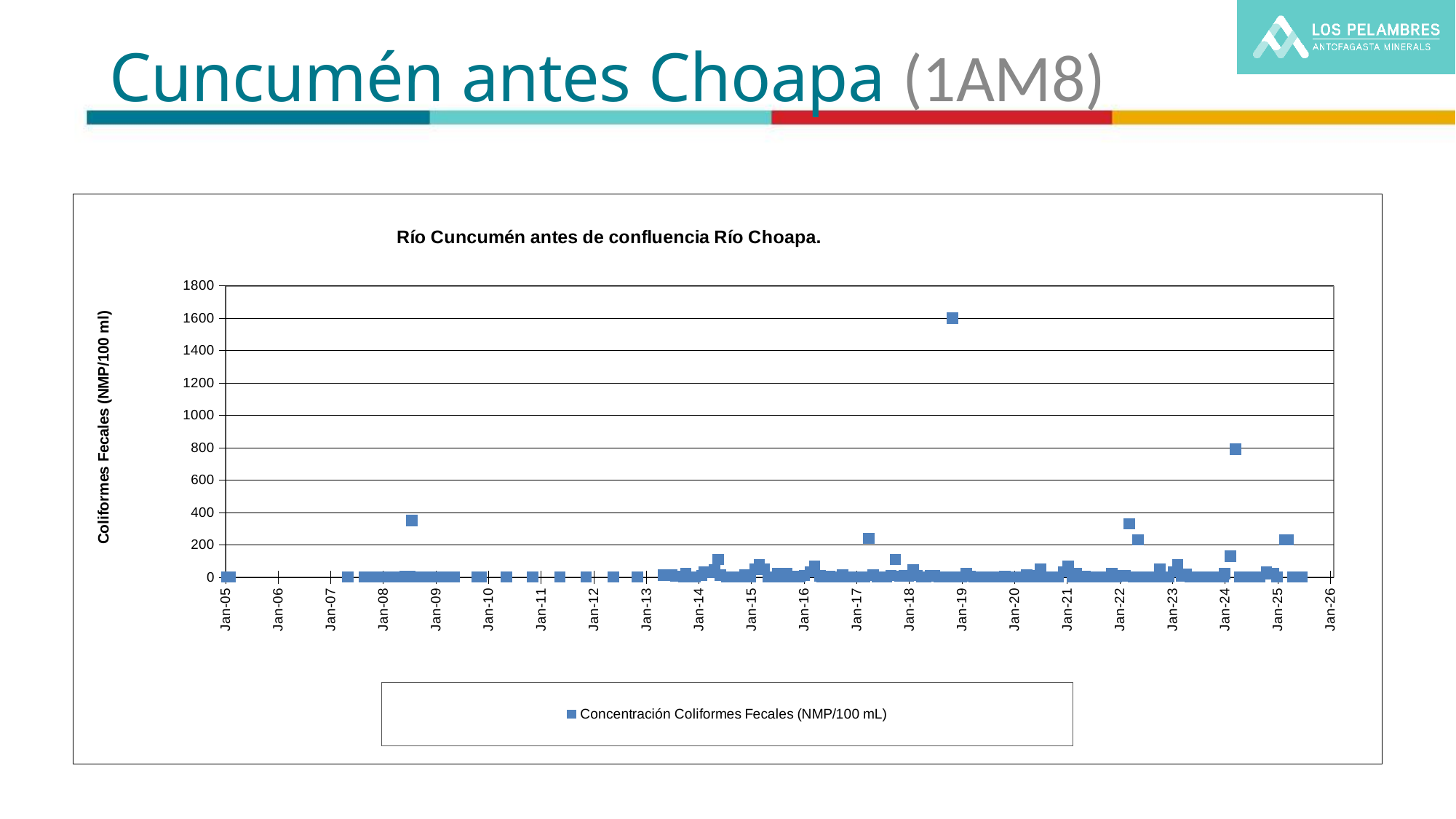
What is the legend entry for the plotted series? Concentración Coliformes Fecales (NMP/100 mL) Is the spike shortly after Jan-24 greater or less than 1000? less How many year ticks are labelled on the x axis, from Jan-05 to Jan-26? 22 Is the highest plotted value (just before Jan-19) greater or less than 1800? less What is the title of the chart? Río Cuncumén antes de confluencia Río Choapa. Around which x-axis tick does the highest value on the chart occur? Just before Jan-19 Which is larger: the spike just before Jan-19 or the spike just after Jan-24? The spike just before Jan-19 Is the spike shortly after Jan-24 greater or less than 600? greater How many series does the legend list? 1 What kind of chart is shown on the slide? Scatter chart